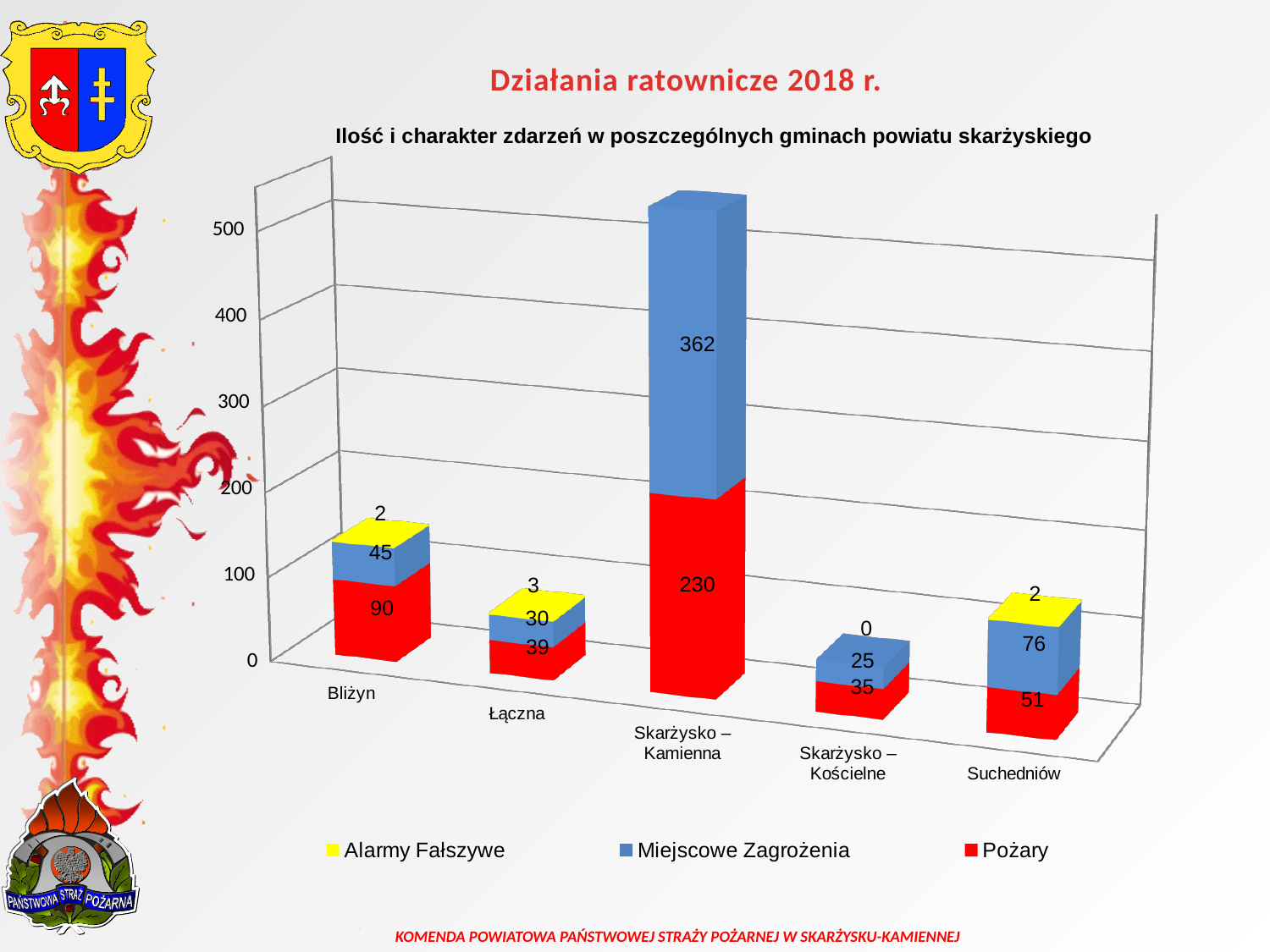
What is the value of Pożary for Skarżysko – Kamienna? 230 Which gmina has the highest value for Miejscowe Zagrożenia? Skarżysko – Kamienna What kind of chart is shown on the slide? Stacked bar chart How many series does the legend list? 3 What is the value of Alarmy Fałszywe for Łączna? 3 How many gminas (categories) are shown on the x axis? 5 What is the value of Miejscowe Zagrożenia for Suchedniów? 76 Which is larger: Miejscowe Zagrożenia for Bliżyn or Miejscowe Zagrożenia for Łączna? Bliżyn What is the value of Miejscowe Zagrożenia for Skarżysko – Kościelne? 25 Which gmina has the lowest value for Pożary? Skarżysko – Kościelne What is the total of the stacked bar for Bliżyn? 137 What is the difference between Pożary for Bliżyn and Pożary for Łączna? 51